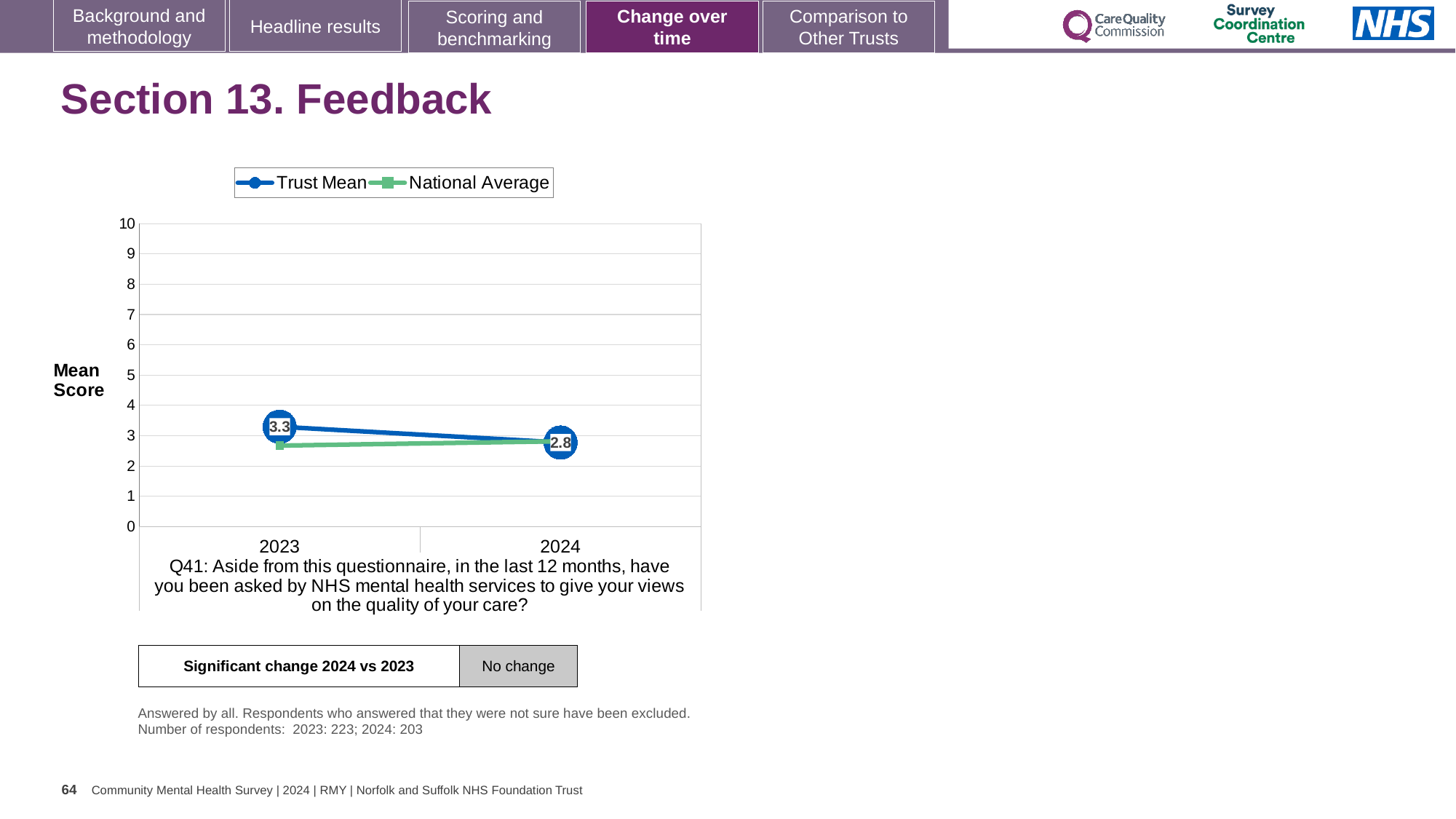
What kind of chart is shown on the slide? line chart Is the National Average value for 2023 greater or less than 3? less What is the Trust Mean value for 2023? 3.3 How many series does the legend list? 2 How many years are plotted on the x axis? 2 In which year is the Trust Mean highest? 2023 What is the Trust Mean value for 2024? 2.8 By how much did the Trust Mean change from 2023 to 2024? 0.5 Does the Trust Mean rise or fall from 2023 to 2024? fall In which year is the Trust Mean lowest? 2024 In 2023, which is larger: the Trust Mean or the National Average? Trust Mean What is the label on the y axis of the chart? Mean Score